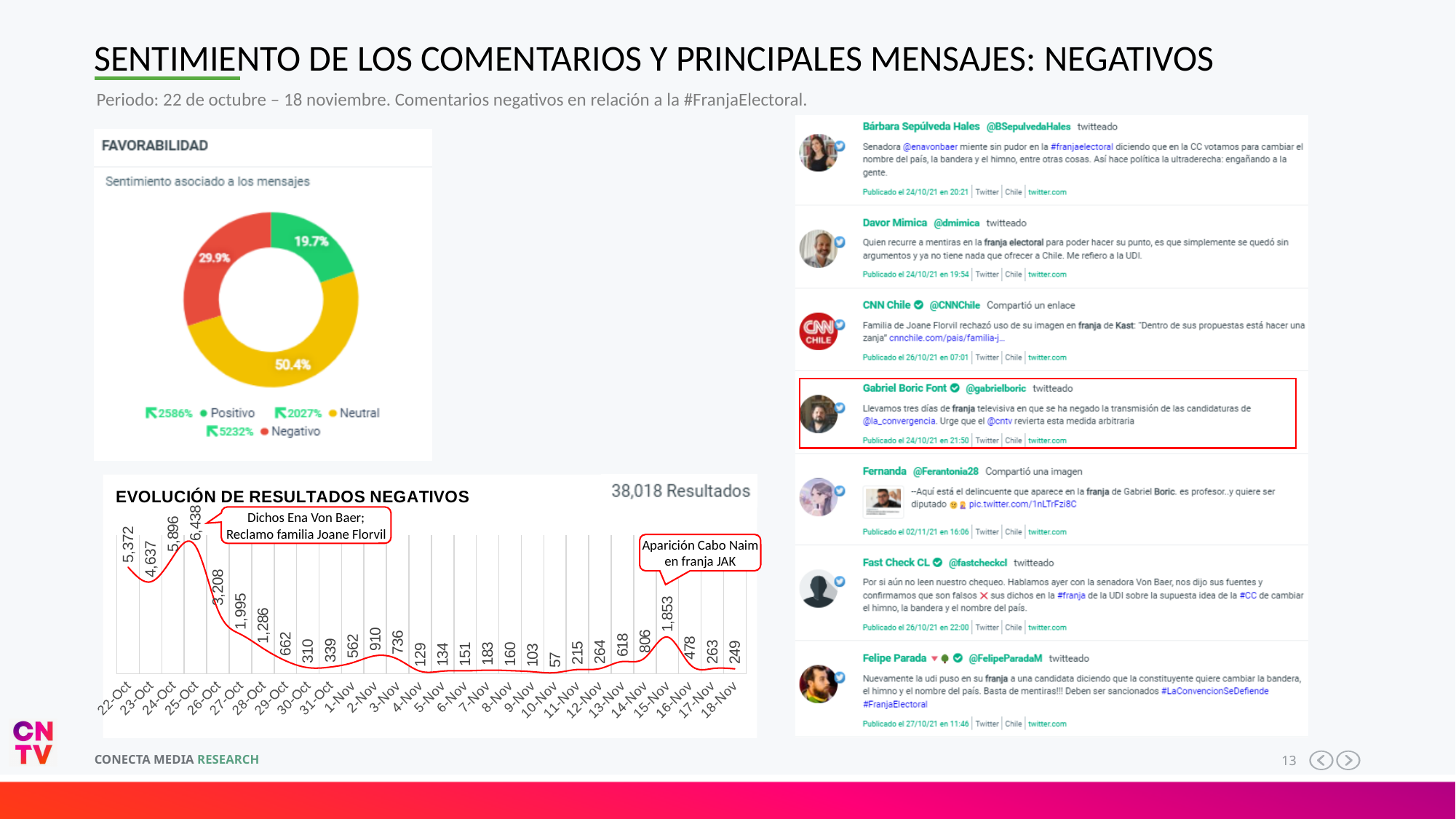
What total number of results is shown in the header of the EVOLUCIÓN DE RESULTADOS NEGATIVOS chart? 38,018 Resultados In the FAVORABILIDAD donut chart, which sentiment has the smallest share? Positivo What kind of chart is the FAVORABILIDAD chart? Donut (pie) chart In the FAVORABILIDAD donut chart, what percentage of messages are Neutral? 50.4% In the EVOLUCIÓN DE RESULTADOS NEGATIVOS chart, which date has the highest value? 25-Oct In the EVOLUCIÓN DE RESULTADOS NEGATIVOS chart, what is the value for 25-Oct? 6,438 How many dates are plotted in the EVOLUCIÓN DE RESULTADOS NEGATIVOS chart? 28 In the EVOLUCIÓN DE RESULTADOS NEGATIVOS chart, which date has the lowest value? 10-Nov In the FAVORABILIDAD donut chart, what percentage of messages are Negativo? 29.9% In the EVOLUCIÓN DE RESULTADOS NEGATIVOS chart, what is the value for 15-Nov? 1,853 In the FAVORABILIDAD donut chart, what is the difference in percentage points between the Negativo and Positivo shares? 10.2 In the EVOLUCIÓN DE RESULTADOS NEGATIVOS chart, which is larger, the value for 2-Nov or the value for 3-Nov? 2-Nov